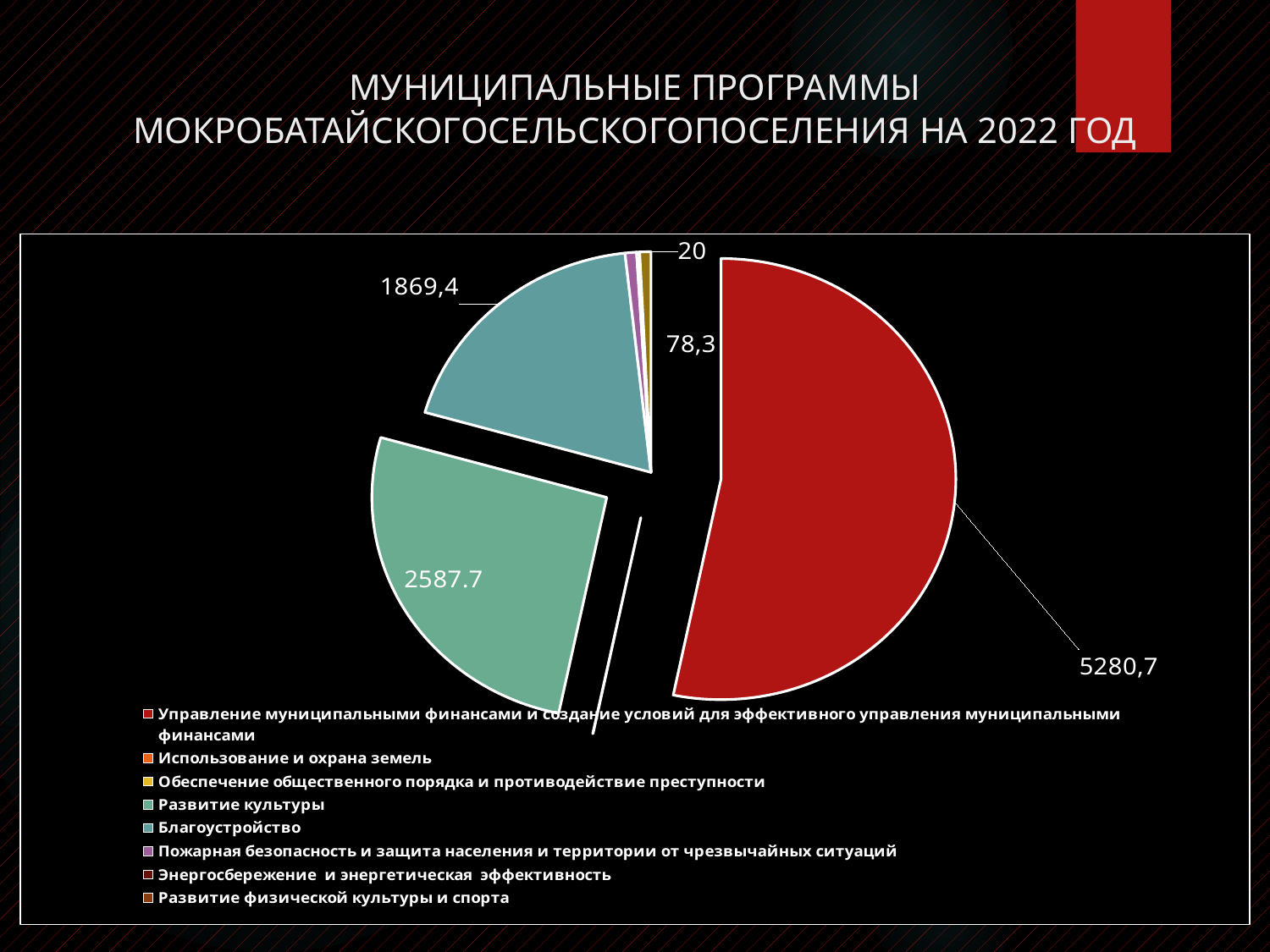
What is the difference between the Развитие культуры value and the Благоустройство value? 718.3 What year is named in the slide title above the pie chart? 2022 What kind of chart is shown on the slide? pie chart What is the value shown for the Развитие культуры slice? 2587.7 What is the value shown for the Благоустройство slice? 1869,4 What is the difference between the largest slice (5280,7) and the Благоустройство slice (1869,4)? 3411,3 What is the difference between the largest slice (5280,7) and the Развитие культуры slice (2587.7)? 2693 How many entries does the legend of the pie chart list? 8 Which program does the red slice of the pie chart represent? Управление муниципальными финансами и создание условий для эффективного управления муниципальными финансами Which program has the largest slice in the pie chart? Управление муниципальными финансами и создание условий для эффективного управления муниципальными финансами What is the value shown for the largest slice of the pie chart? 5280,7 Which slice is larger: Развитие культуры or Благоустройство? Развитие культуры